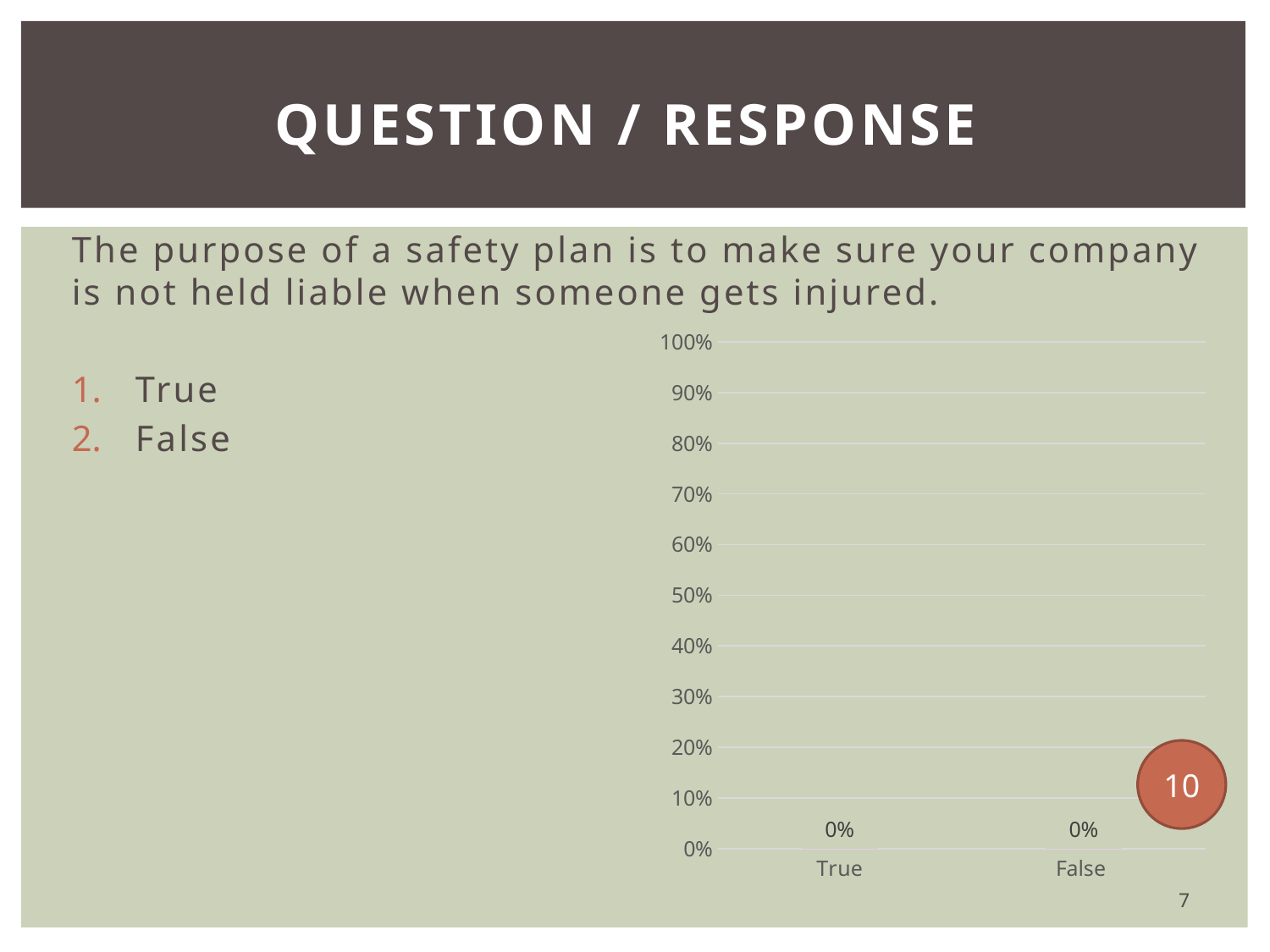
What is the difference between the values for True and False? 0% What is the value shown for False in the chart? 0% What is the value shown for True in the chart? 0% What is the highest value shown on the chart's y axis? 100% What are the two category labels on the x axis of the chart? True and False Is the value for True greater or less than 10%? less What kind of chart is shown on the slide? bar chart How many categories are shown on the x axis of the chart? 2 Is the value for False greater or less than 50%? less